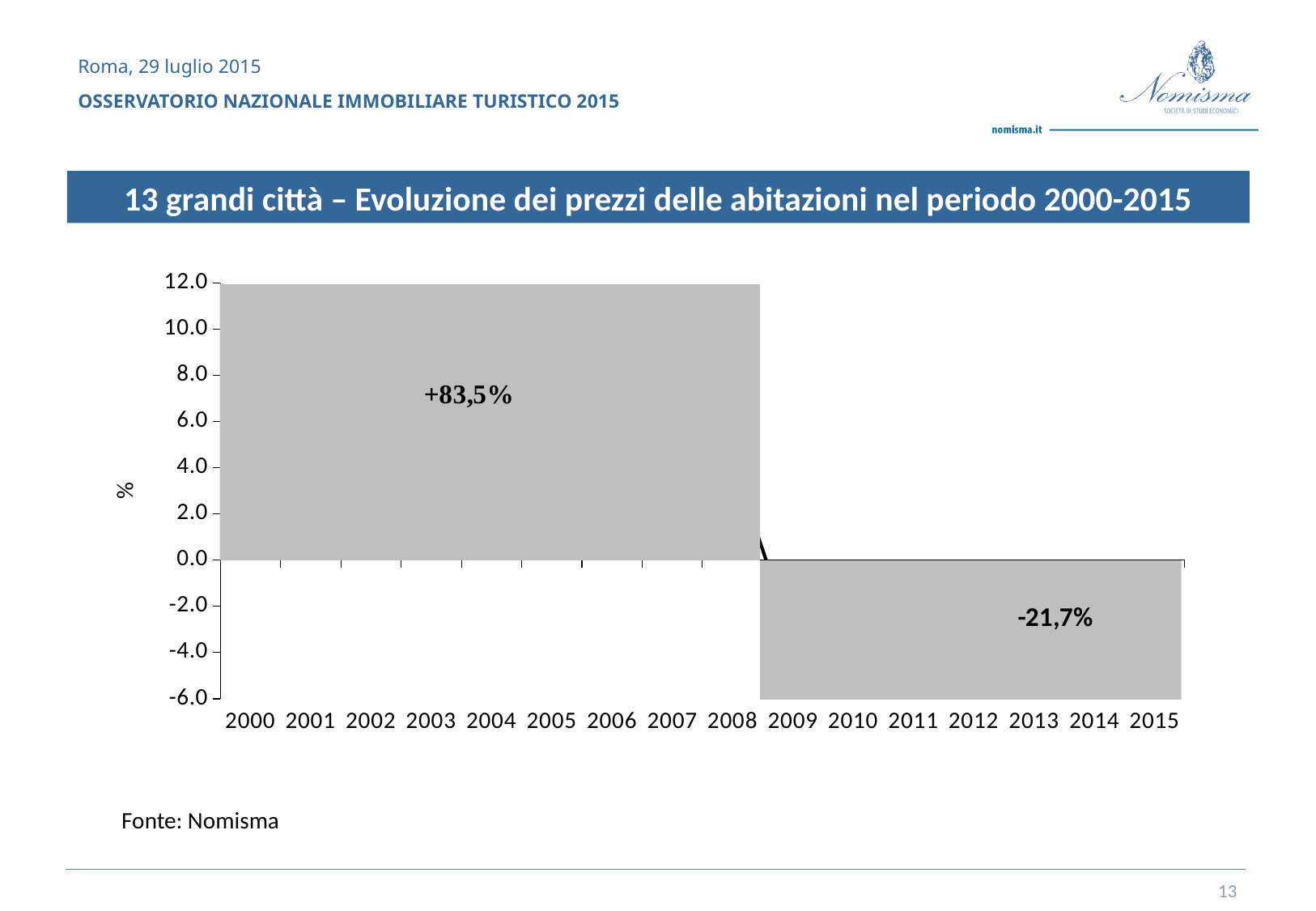
What cumulative price change is annotated for the period 2009-2015? -21,7% What unit is shown on the y axis label of the chart? % How many years are listed along the x axis of the chart? 16 What is the title of the chart? 13 grandi città – Evoluzione dei prezzi delle abitazioni nel periodo 2000-2015 Which annotated period shows a positive change, 2000-2008 or 2009-2015? 2000-2008 What cumulative price change is annotated for the period 2000-2008? +83,5% According to the annotation, did housing prices rise or fall over the period 2009-2015? fall Is the annotated change for 2009-2015 greater or less than -20%? less According to the annotation, did housing prices rise or fall over the period 2000-2008? rise What kind of chart is shown on the slide? line chart Is the annotated change for 2000-2008 greater or less than 80%? greater